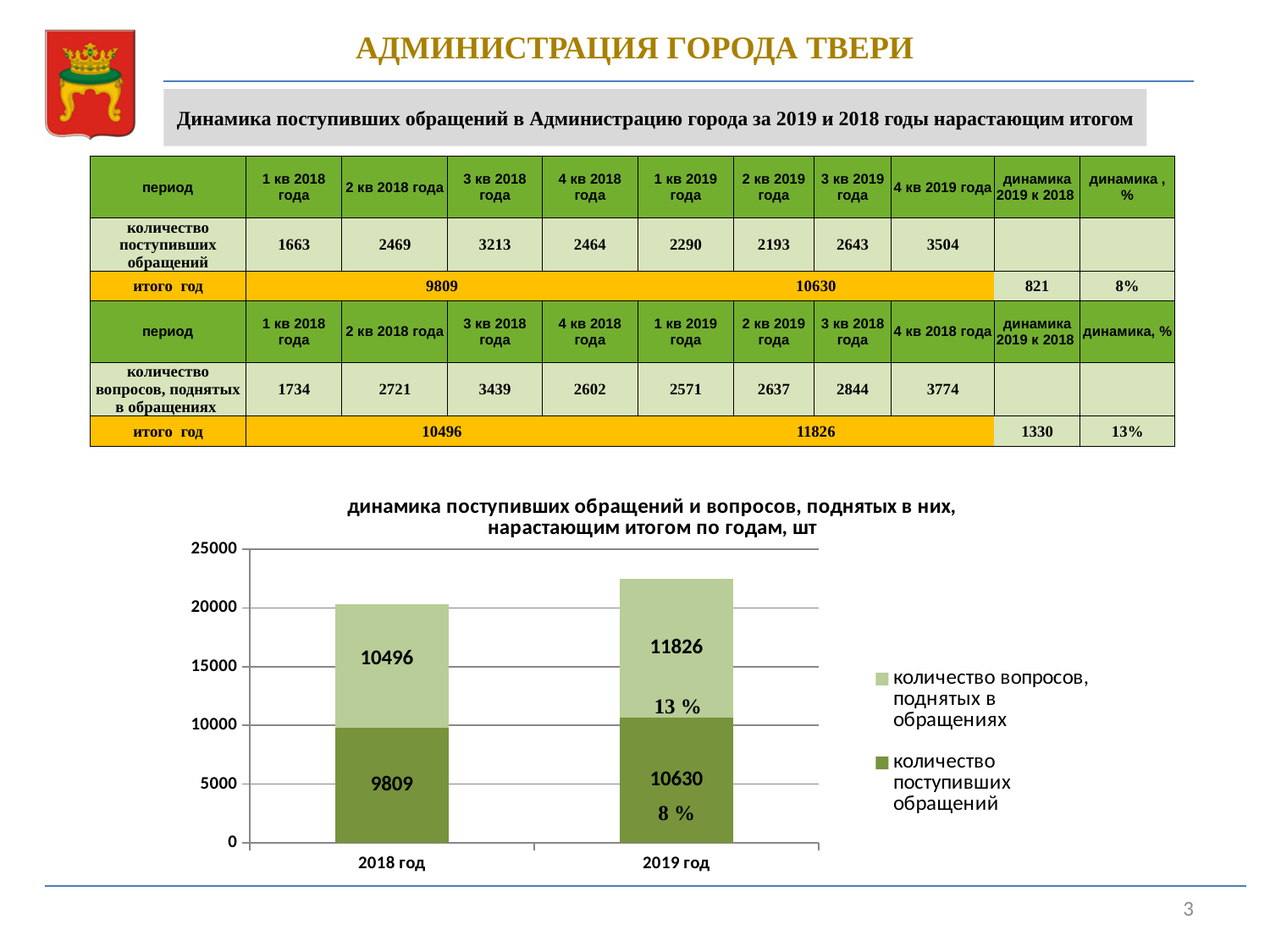
What is the value of "количество вопросов, поднятых в обращениях" for 2019 год? 11826 What is the total of the stacked bar for 2019 год? 22456 What is the difference between the "количество вопросов, поднятых в обращениях" values for 2019 год and 2018 год? 1330 Which year has the larger value for "количество поступивших обращений", 2018 год or 2019 год? 2019 год What is the total of the stacked bar for 2018 год? 20305 How many series does the chart legend list? 2 What type of chart is shown on the slide? stacked bar chart How many categories are shown on the x axis of the chart? 2 What is the value of "количество поступивших обращений" for 2018 год? 9809 What is the value of "количество поступивших обращений" for 2019 год? 10630 Does the total of the stacked bars rise or fall from 2018 год to 2019 год? rise What is the value of "количество вопросов, поднятых в обращениях" for 2018 год? 10496